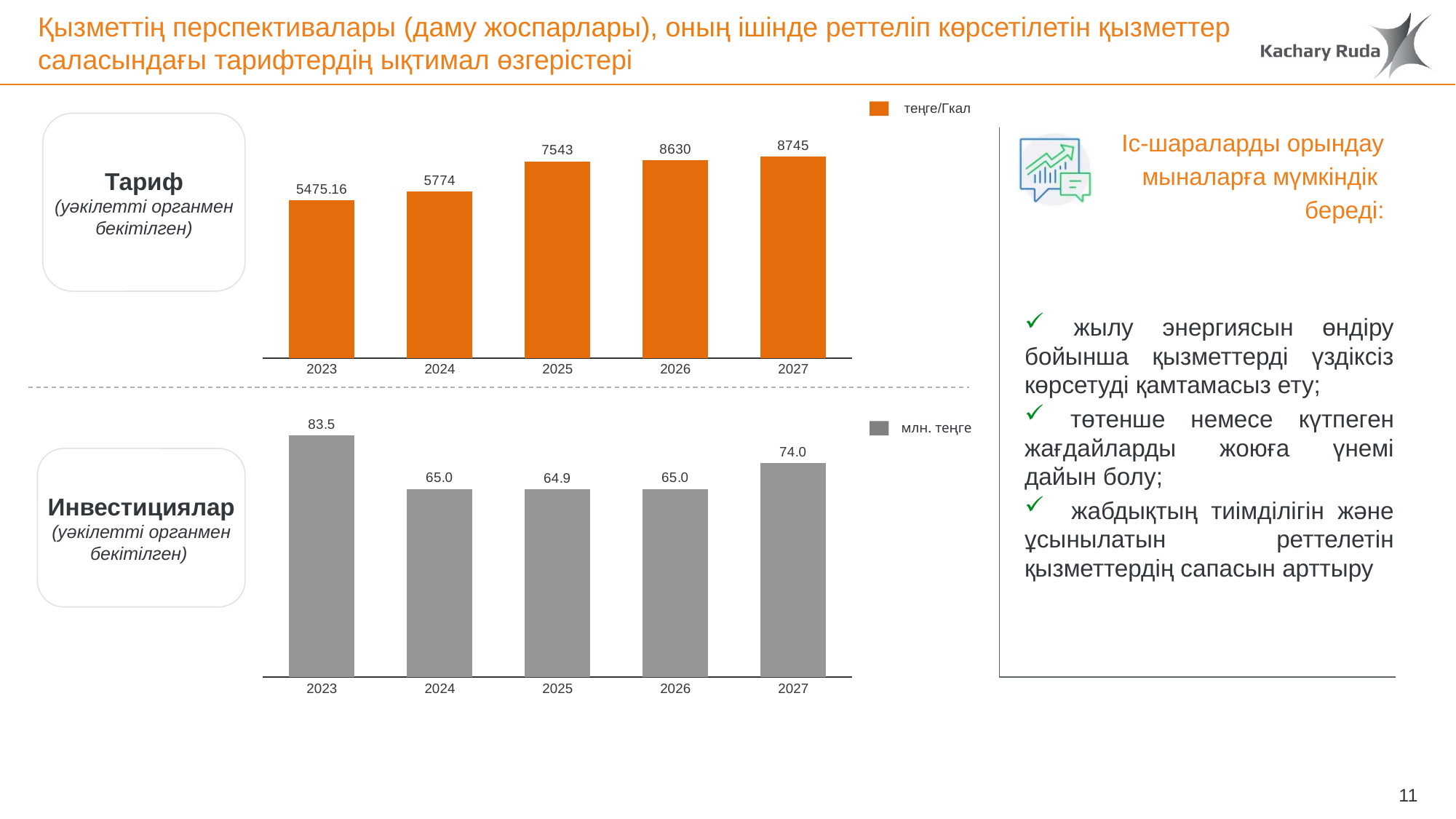
In the bottom chart (Инвестициялар), what is the difference between the 2023 and 2027 values? 9.5 In the top chart (Тариф), which year has the highest value? 2027 In the top chart (Тариф), do the values rise or fall from 2023 to 2027? rise In the bottom chart (Инвестициялар), which is larger, the value for 2027 or the value for 2026? 2027 In the top chart (Тариф), what unit does the legend give? теңге/Гкал In the bottom chart (Инвестициялар), which year has the lowest value? 2025 How many years are shown on the x axis of the bottom chart (Инвестициялар)? 5 In the top chart (Тариф), what is the difference between the 2025 and 2024 values? 1769 In the bottom chart (Инвестициялар), what is the value for 2025? 64.9 In the top chart (Тариф), what is the value for 2026? 8630 In the bottom chart (Инвестициялар), what is the value for 2023? 83.5 In the top chart (Тариф), what is the value for 2023? 5475.16